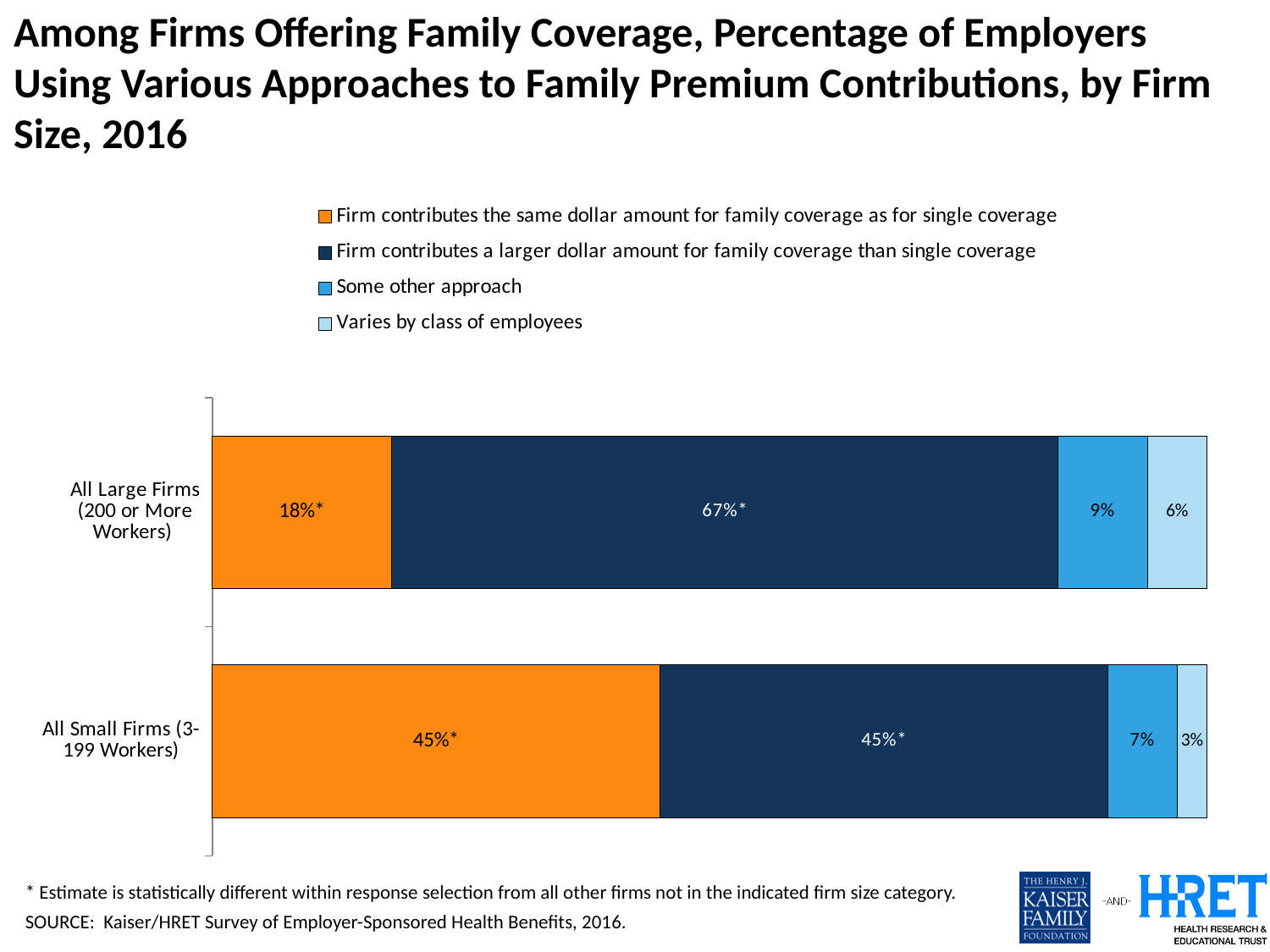
Which firm size category has the higher percentage of firms contributing the same dollar amount for family coverage as for single coverage? All Small Firms (3-199 Workers) What percentage of all small firms (3-199 workers) contribute the same dollar amount for family coverage as for single coverage? 45% What percentage of all large firms (200 or more workers) contribute a larger dollar amount for family coverage than single coverage? 67% How many firm size categories are shown in the chart? 2 What percentage of all large firms use some other approach? 9% What percentage of all small firms report that the approach varies by class of employees? 3% What is the difference between large firms and small firms in the percentage contributing a larger dollar amount for family coverage than single coverage? 22 percentage points How many series does the legend list? 4 Is the percentage using some other approach larger for large firms or for small firms? All Large Firms (200 or More Workers) What kind of chart is shown on the slide? Stacked bar chart Which firm size category has the lower percentage for 'Varies by class of employees'? All Small Firms (3-199 Workers) What is the total of the segments in the bar for all large firms (200 or more workers)? 100%